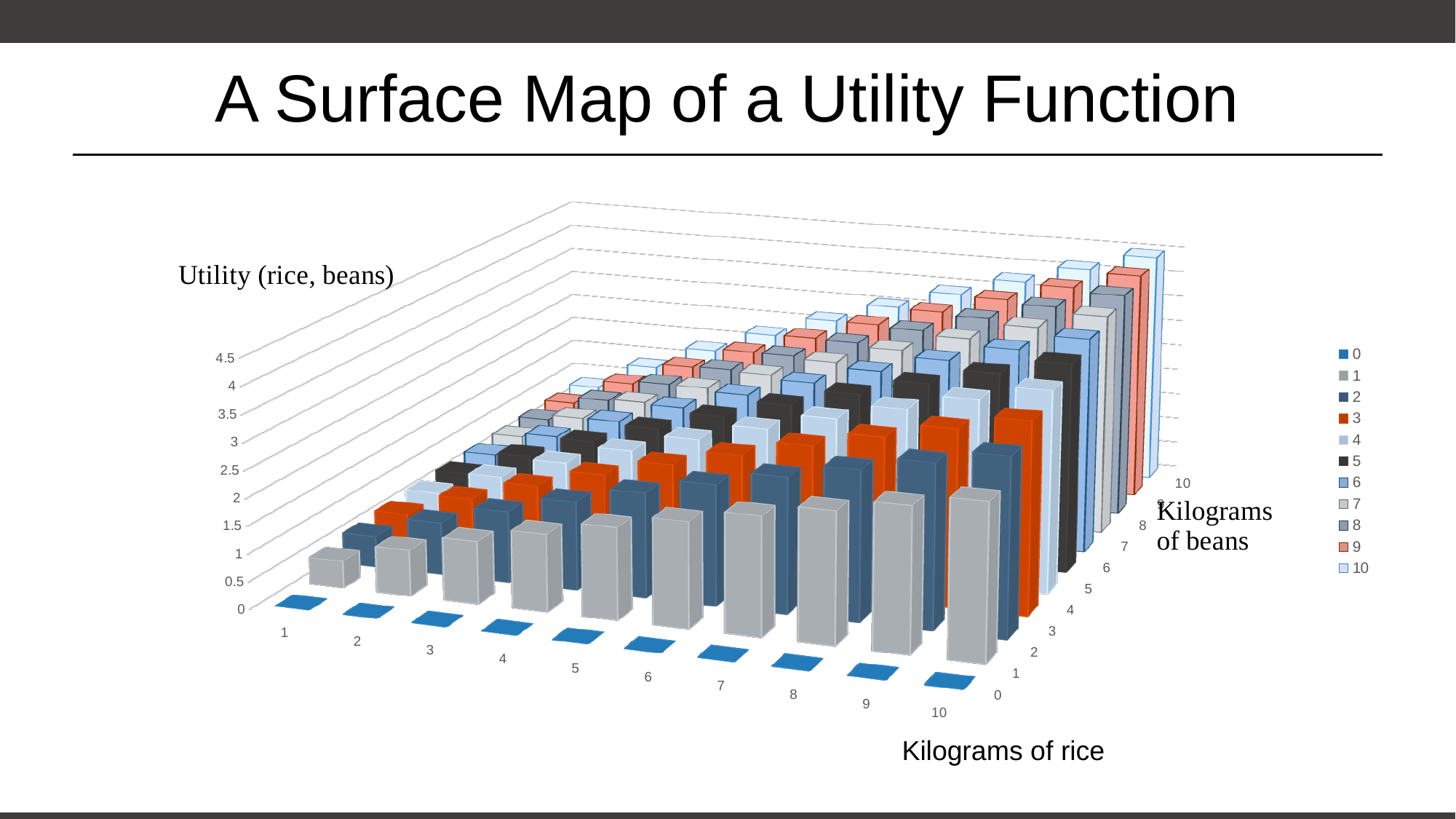
Is the value for the series labelled 0 at 5 kilograms of rice greater or less than 0.5? less What kind of chart is shown on the slide? bar chart For the series labelled 1 (one kilogram of beans), do the bars rise or fall as kilograms of rice increase from 1 to 10? rise What is the label of the vertical axis? Utility (rice, beans) How many series does the legend list? 11 For the series labelled 10 (ten kilograms of beans), do the bars rise or fall as kilograms of rice increase? rise What is the highest tick value shown on the vertical axis? 4.5 In the series labelled 1, which bar is larger: the one at 10 kilograms of rice or the one at 1 kilogram of rice? 10 kilograms of rice Within the series labelled 1, at which kilograms of rice value is the bar highest? 10 How many categories are shown along the Kilograms of rice axis? 10 What is the title of the chart? A Surface Map of a Utility Function Within the series labelled 1, at which kilograms of rice value is the bar lowest? 1